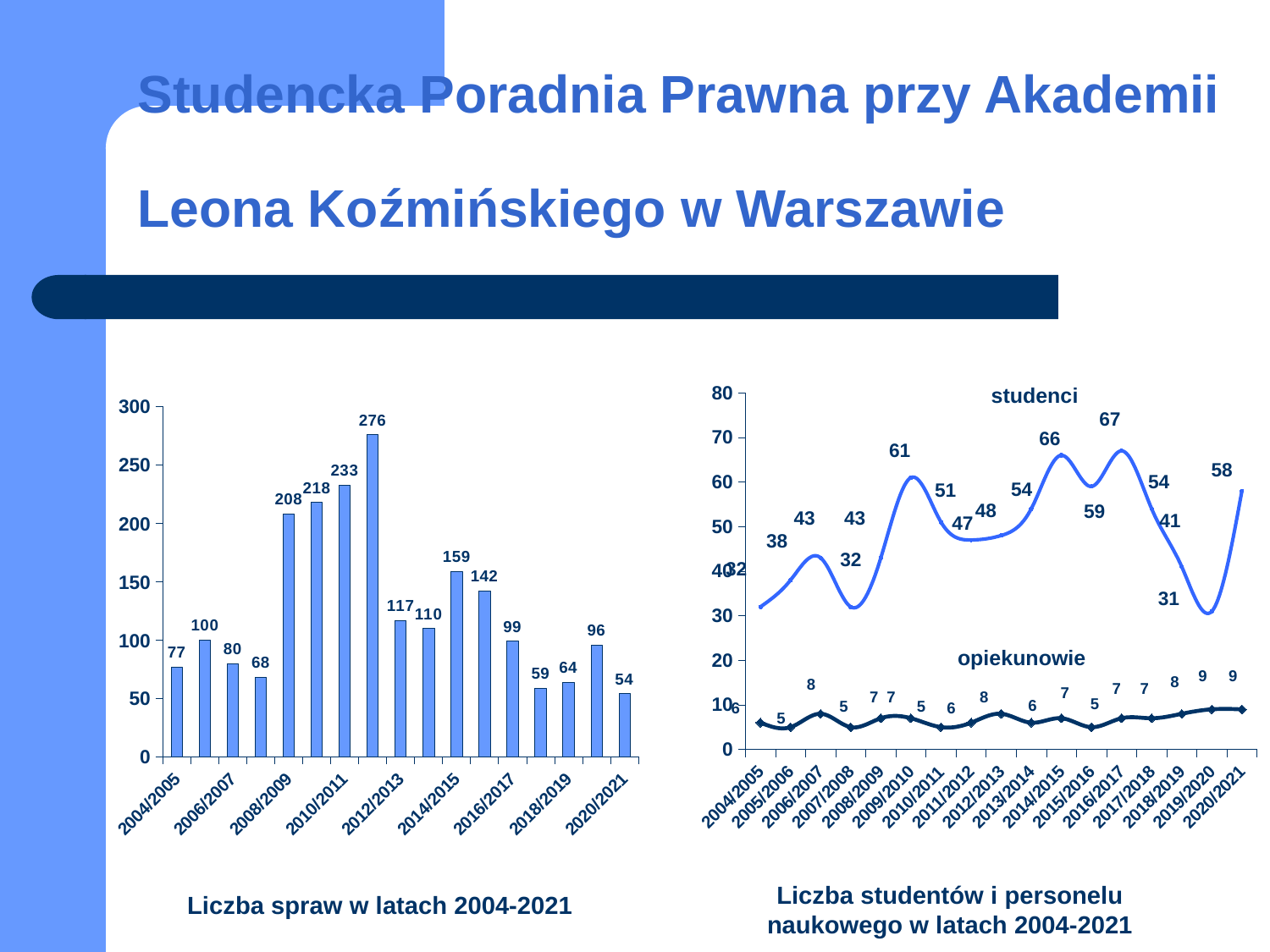
In the left chart 'Liczba spraw w latach 2004-2021', what is the highest value shown? 276 In the right chart, how many series are plotted? 2 In the right chart, which is larger in 2009/2010: studenci or opiekunowie? studenci In the left chart 'Liczba spraw w latach 2004-2021', what is the value for 2008/2009? 208 In the right chart, what is the highest value for studenci? 67 What type of chart is the left chart, 'Liczba spraw w latach 2004-2021'? bar chart In the left chart 'Liczba spraw w latach 2004-2021', which year has the lowest value? 2020/2021 What type of chart is the right chart, 'Liczba studentów i personelu naukowego w latach 2004-2021'? line chart In the left chart 'Liczba spraw w latach 2004-2021', how many bars are plotted? 17 In the left chart 'Liczba spraw w latach 2004-2021', what is the difference between the values for 2010/2011 and 2004/2005? 156 In the left chart 'Liczba spraw w latach 2004-2021', what is the value for 2014/2015? 159 In the right chart, what is the value for studenci in 2020/2021? 58